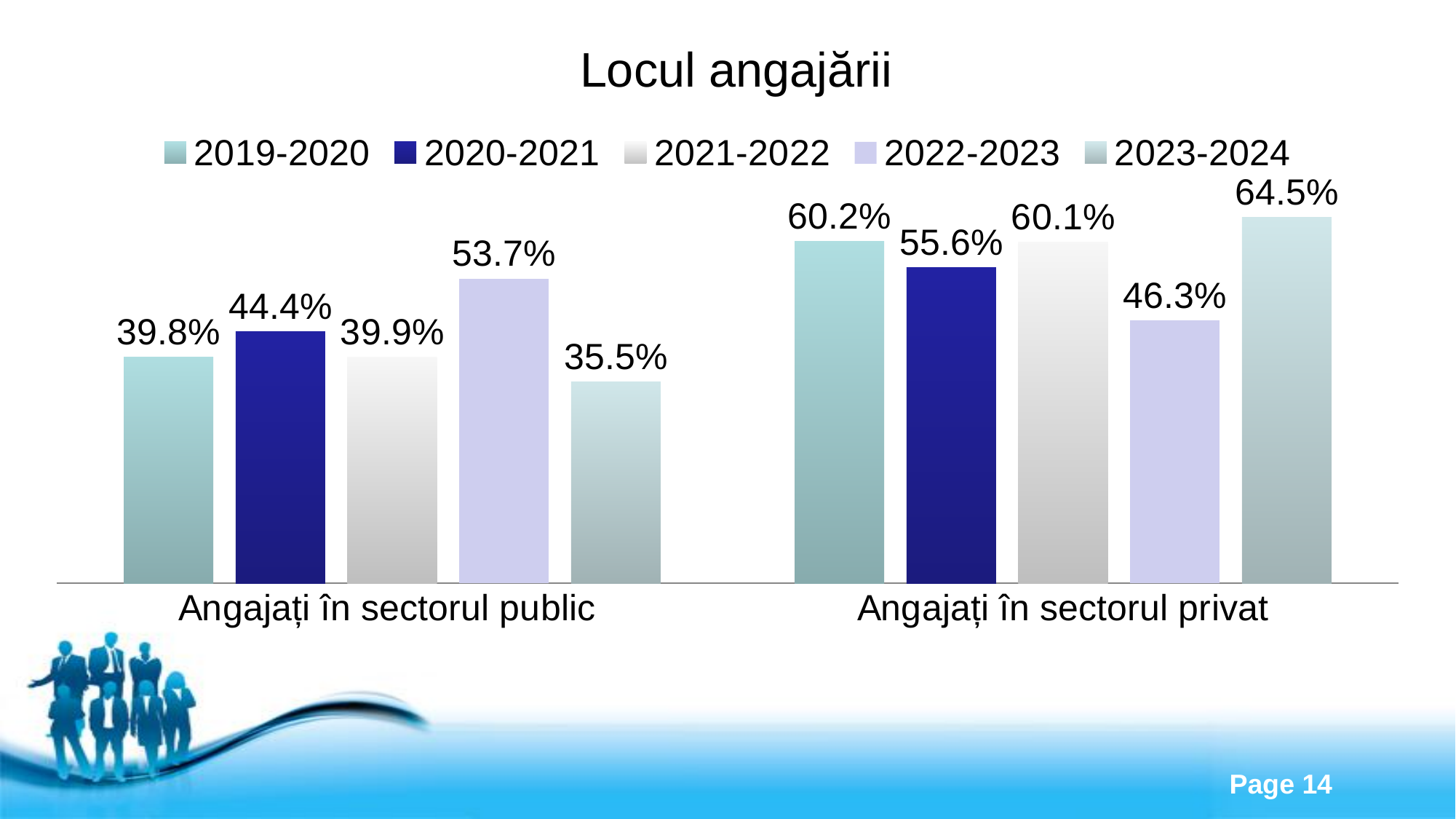
What is the value for 2019-2020 in the 'Angajați în sectorul privat' category? 60.2% Which series has the highest value in the 'Angajați în sectorul public' category? 2022-2023 What is the difference between the 2023-2024 values for 'Angajați în sectorul privat' and 'Angajați în sectorul public'? 29.0 percentage points What is the title of the chart? Locul angajării What kind of chart is shown on the slide? Bar chart What is the value for 2022-2023 in the 'Angajați în sectorul public' category? 53.7% What is the value for 2023-2024 in the 'Angajați în sectorul privat' category? 64.5% Which series has the lowest value in the 'Angajați în sectorul privat' category? 2022-2023 How many categories are shown on the x axis? 2 How many series does the legend list? 5 Which is larger: the 2020-2021 value for 'Angajați în sectorul public' or the 2021-2022 value for 'Angajați în sectorul public'? 2020-2021 What is the difference between the 2022-2023 and 2023-2024 values in the 'Angajați în sectorul public' category? 18.2 percentage points